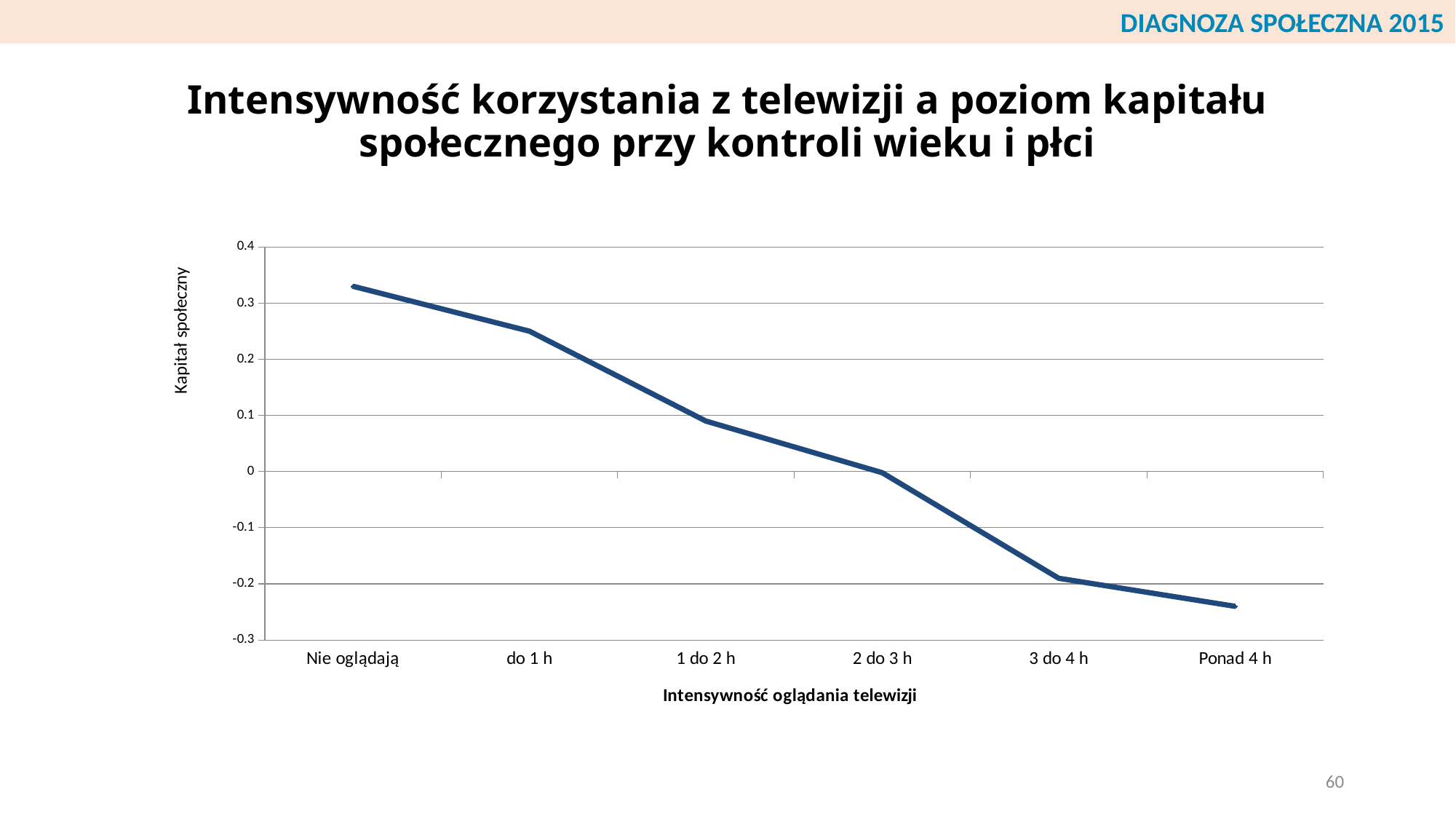
Do the values rise or fall along the x axis from 'Nie oglądają' to 'Ponad 4 h'? fall Is the value for '1 do 2 h' greater or less than 0.2? less How many categories are shown on the x axis of the chart? 6 Which category has the lowest value of Kapitał społeczny? Ponad 4 h What is the title of the x axis of the chart? Intensywność oglądania telewizji Which has a larger value: 'do 1 h' or '3 do 4 h'? do 1 h Is the value for 'do 1 h' greater or less than 0.2? greater What is the title of the y axis of the chart? Kapitał społeczny Is the value for '3 do 4 h' greater or less than -0.1? less Which category has the highest value of Kapitał społeczny? Nie oglądają What kind of chart is shown on the slide? line chart